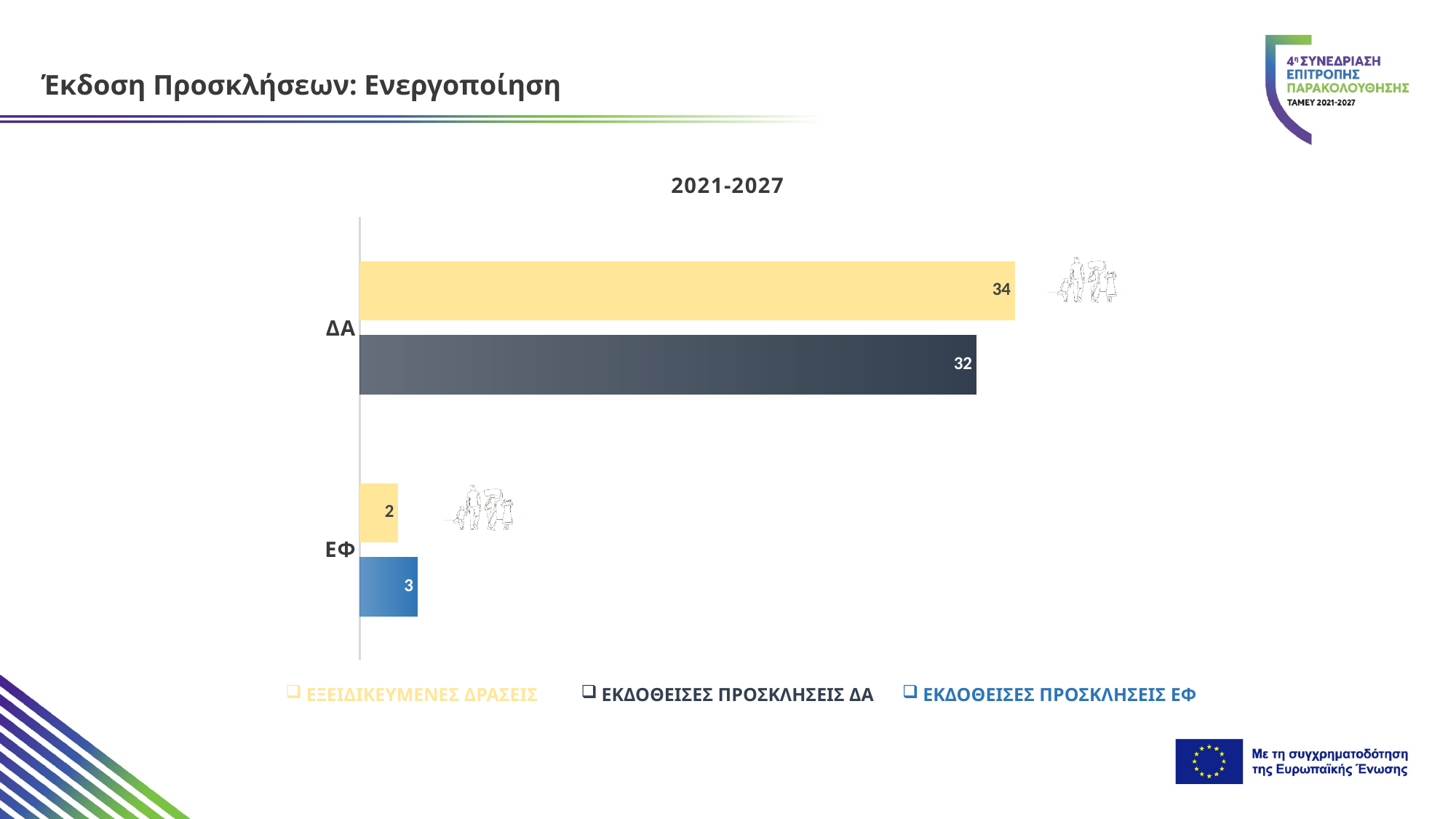
How many series does the legend list? 3 What kind of chart is shown on the slide? Bar chart Which is larger for ΕΦ: ΕΞΕΙΔΙΚΕΥΜΕΝΕΣ ΔΡΑΣΕΙΣ or ΕΚΔΟΘΕΙΣΕΣ ΠΡΟΣΚΛΗΣΕΙΣ ΕΦ? ΕΚΔΟΘΕΙΣΕΣ ΠΡΟΣΚΛΗΣΕΙΣ ΕΦ Which category has the highest value of ΕΞΕΙΔΙΚΕΥΜΕΝΕΣ ΔΡΑΣΕΙΣ? ΔΑ What is the value of ΕΞΕΙΔΙΚΕΥΜΕΝΕΣ ΔΡΑΣΕΙΣ for ΕΦ? 2 What colour are the bars for ΕΞΕΙΔΙΚΕΥΜΕΝΕΣ ΔΡΑΣΕΙΣ? Yellow What is the value of ΕΚΔΟΘΕΙΣΕΣ ΠΡΟΣΚΛΗΣΕΙΣ ΕΦ for ΕΦ? 3 What is the value of ΕΚΔΟΘΕΙΣΕΣ ΠΡΟΣΚΛΗΣΕΙΣ ΔΑ for ΔΑ? 32 What is the title of the chart? 2021-2027 What is the difference between ΕΞΕΙΔΙΚΕΥΜΕΝΕΣ ΔΡΑΣΕΙΣ and ΕΚΔΟΘΕΙΣΕΣ ΠΡΟΣΚΛΗΣΕΙΣ ΔΑ for ΔΑ? 2 How many categories are shown on the vertical axis? 2 What is the value of ΕΞΕΙΔΙΚΕΥΜΕΝΕΣ ΔΡΑΣΕΙΣ for ΔΑ? 34